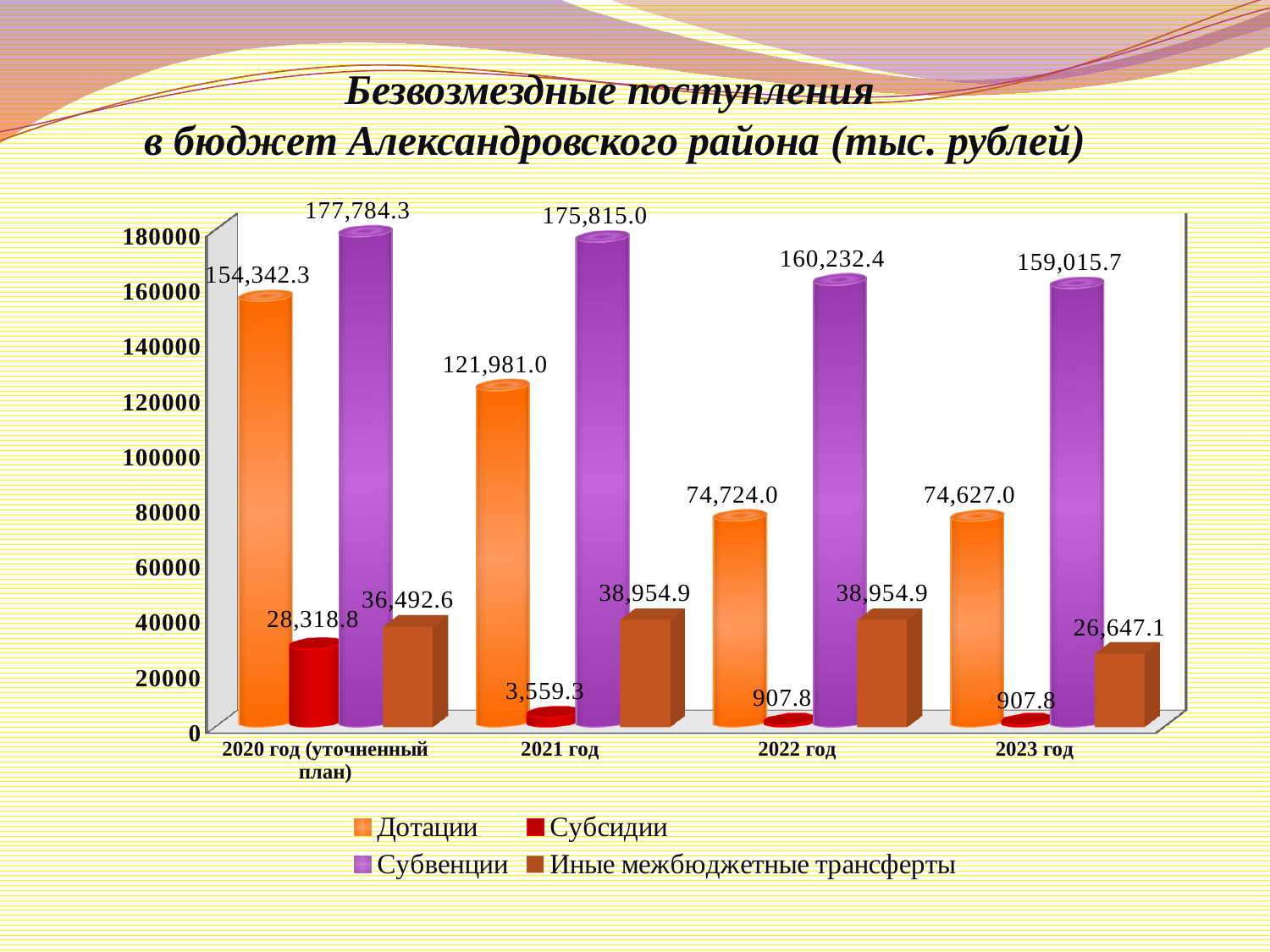
How many series does the legend list? 4 What kind of chart is shown on the slide? Bar chart How many years (categories) are shown on the x axis? 4 What is the value of Дотации for 2020 год (уточненный план)? 154,342.3 What is the value of Субвенции for 2021 год? 175,815.0 In which year is the value of Субвенции the highest? 2020 год (уточненный план) Do the values of Дотации rise or fall from 2020 to 2023? Fall What is the value of Субсидии for 2022 год? 907.8 What is the value of Иные межбюджетные трансферты for 2023 год? 26,647.1 What is the difference between Дотации in 2020 год (уточненный план) and in 2023 год? 79,715.3 Which is larger: Иные межбюджетные трансферты in 2021 год or in 2023 год? 2021 год In which year is the value of Субсидии the lowest? 2022 год and 2023 год (907.8)